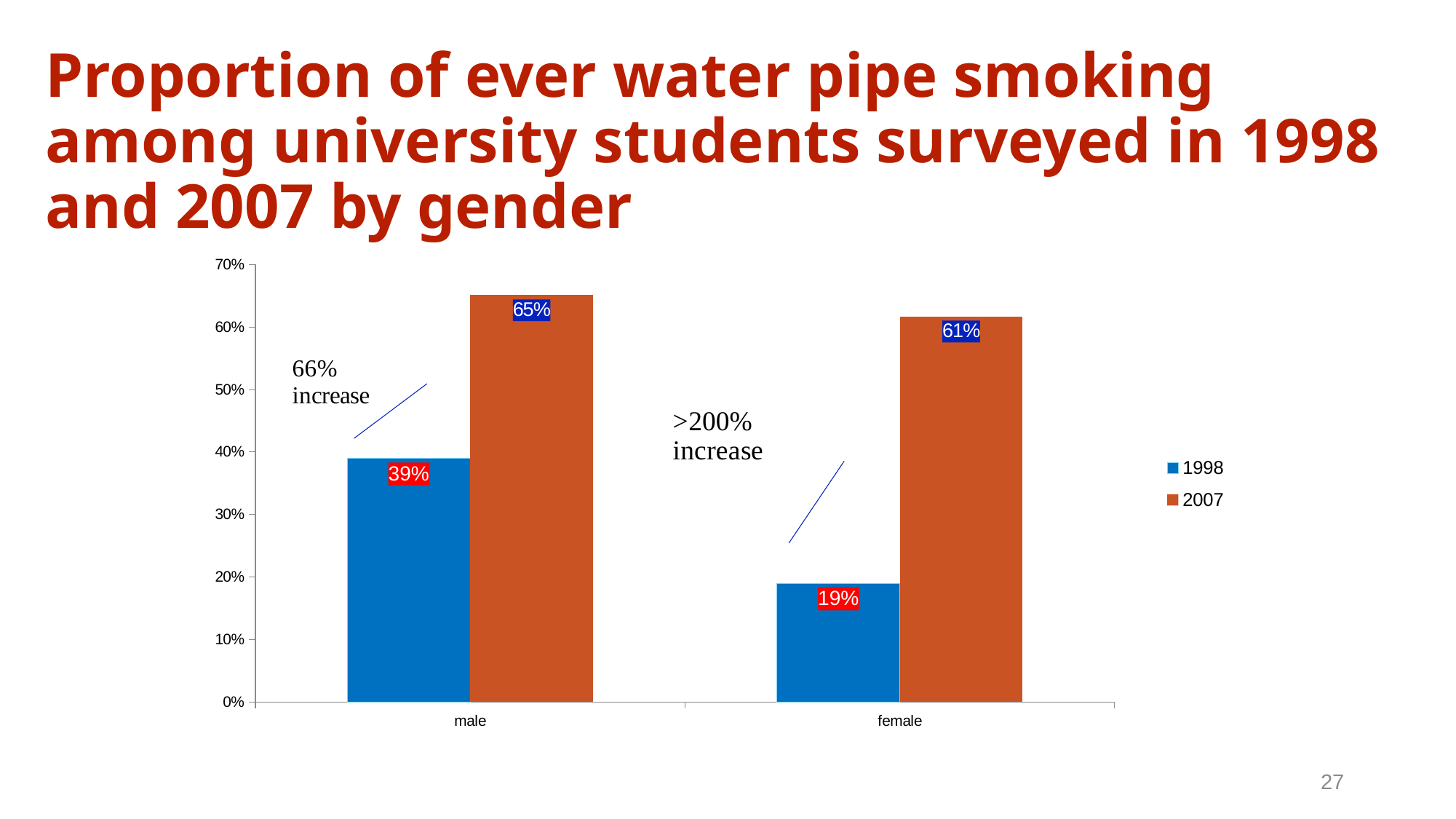
Which category has the lowest value in the 1998 series? female What is the value for male in 2007? 65% Which is larger, the 1998 value for male or the 1998 value for female? male How many series does the legend list? 2 What is the value for female in 1998? 19% What is the value for female in 2007? 61% What is the difference between the male and female values in 1998? 20% How many categories are shown on the x axis? 2 Which category has the highest value in the 2007 series? male What kind of chart is shown on the slide? bar chart What is the difference between the 2007 and 1998 values for female? 42% What is the value for male in 1998? 39%